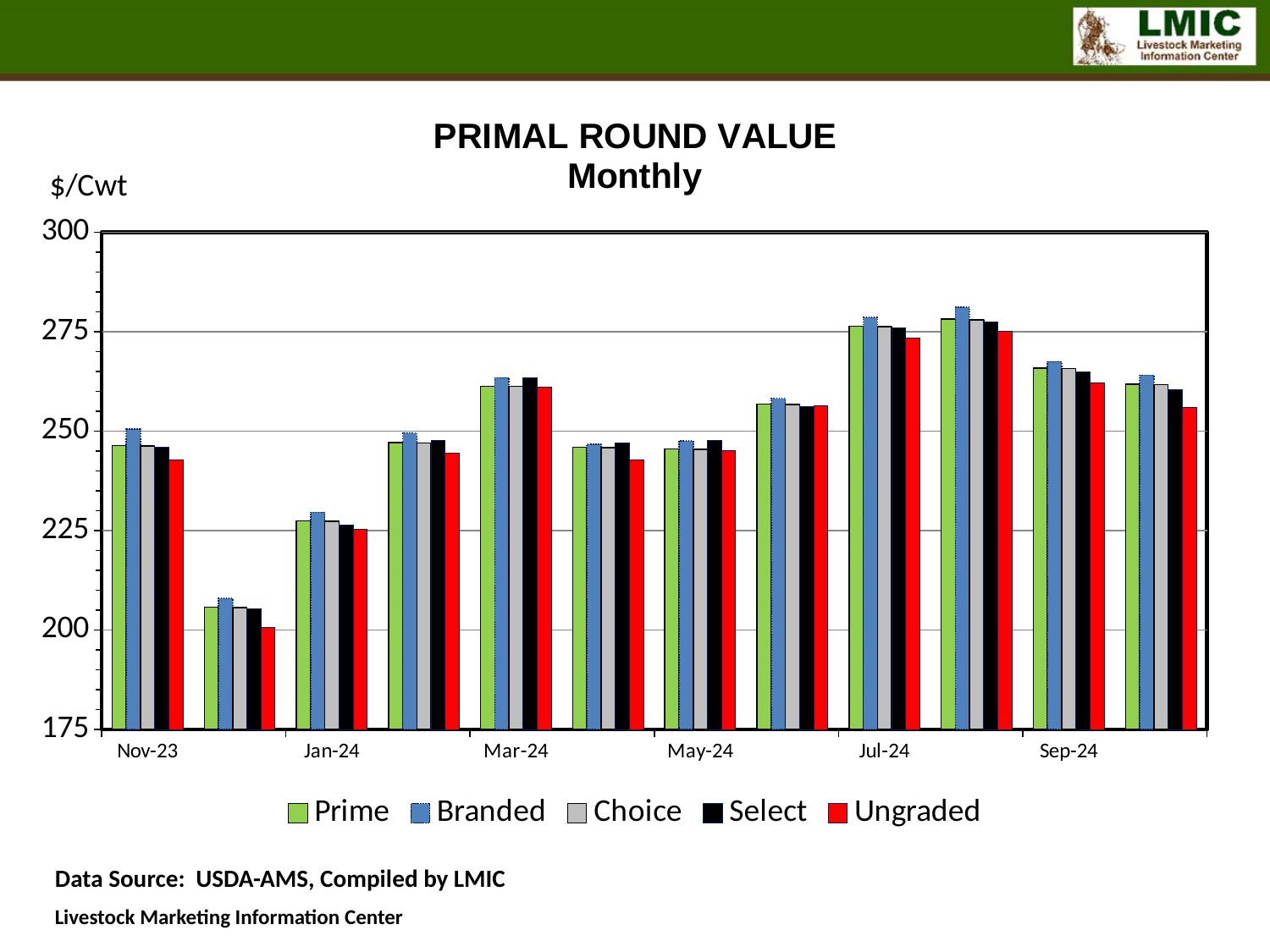
Is the Select value for Sep-24 greater or less than 250? greater How many series does the legend list? 5 What unit is shown on the y axis of the chart? $/Cwt Is the Ungraded value for Nov-23 greater or less than 250? less What kind of chart is shown on the slide? bar chart Which is larger, the Prime value for Jul-24 or the Prime value for Jan-24? Jul-24 Is the Prime value for Mar-24 greater or less than 250? greater How many monthly groups of bars are plotted in the chart? 12 Between Jan-24 and Mar-24, do the Prime values rise or fall? rise Among the months labeled on the x axis, which has the highest Prime value? Jul-24 Which colour represents the Ungraded series in the legend? red